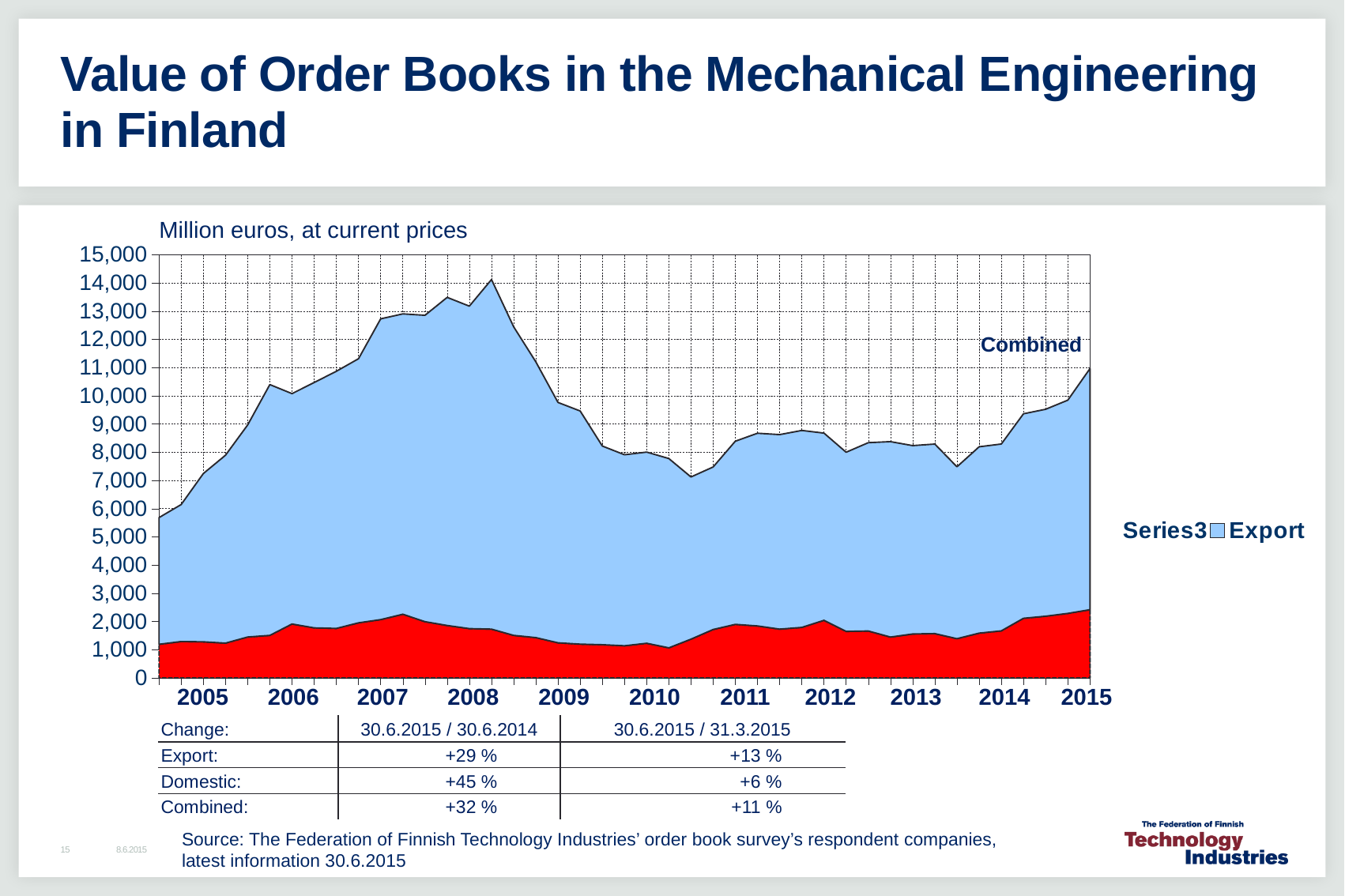
Is the red (domestic) area at the end of 2015 greater or less than 2,000? greater According to the table below the chart, what is the change in Export for 30.6.2015 / 30.6.2014? +29 % What kind of chart is shown on the slide? Area chart How many series does the chart legend list? 2 Does the combined value rise or fall between 2008 and 2009? Fall Is the combined value at its 2008 peak greater or less than 13,000? greater Is the combined value at the end of the series in 2015 greater or less than 10,000? greater Which series is shown in light blue according to the legend? Export What unit is stated above the chart? Million euros, at current prices According to the table below the chart, what is the change in Combined for 30.6.2015 / 31.3.2015? +11 % In which year does the combined value of order books reach its highest peak? 2008